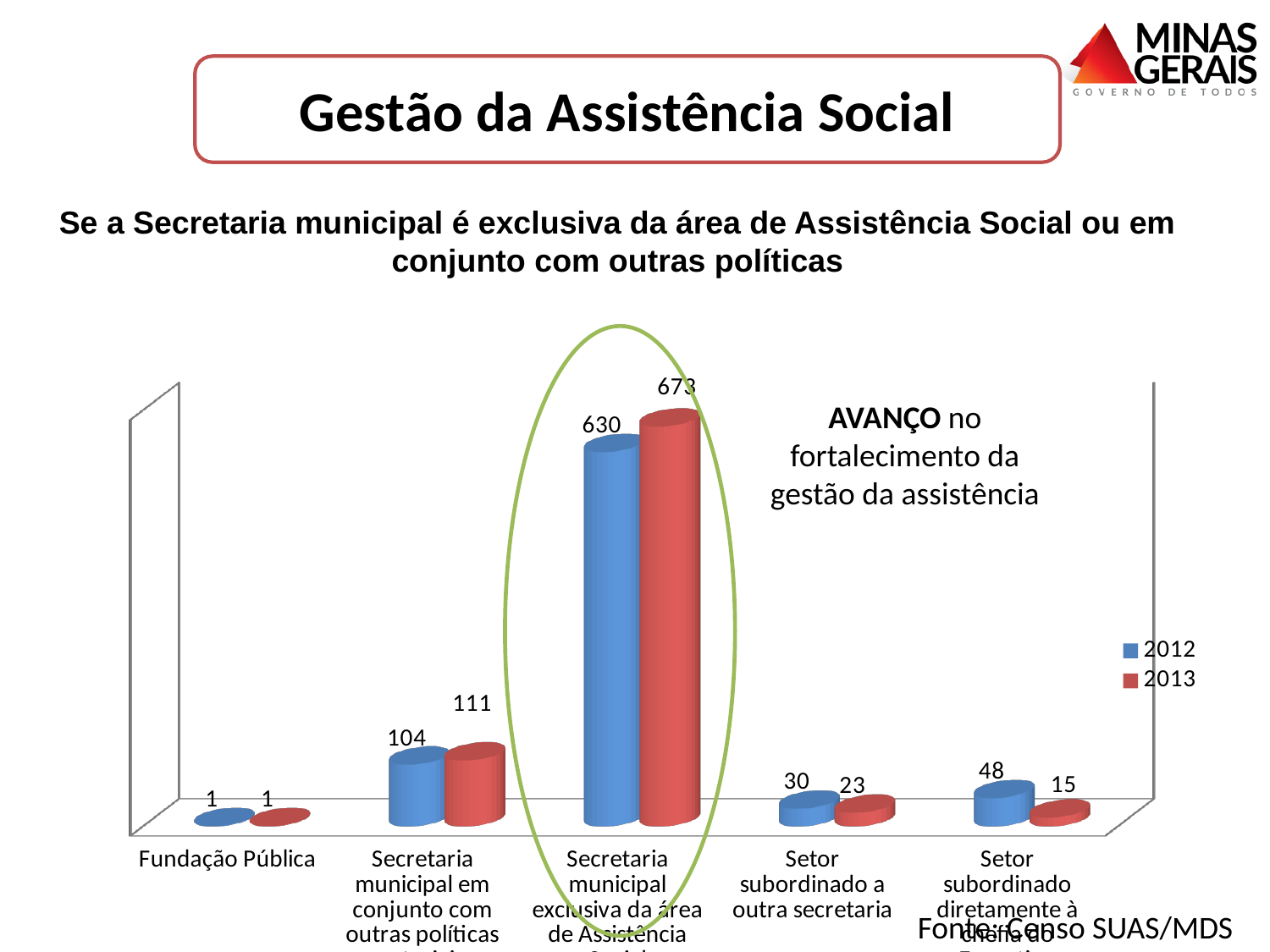
Which category has the lowest 2013 value? Fundação Pública What kind of chart is shown on the slide? Bar chart What is the difference between the 2013 and 2012 values for 'Secretaria municipal exclusiva da área de Assistência Social'? 43 What is the 2013 value for 'Secretaria municipal exclusiva da área de Assistência Social'? 673 How many categories are shown on the x axis of the chart? 5 Which colour represents the 2013 series in the chart? Red For 'Setor subordinado diretamente à chefia do Executivo', which year has the larger value, 2012 or 2013? 2012 Which category has the highest 2012 value? Secretaria municipal exclusiva da área de Assistência Social What is the 2012 value for 'Fundação Pública'? 1 How many series does the chart legend list? 2 What is the 2013 value for 'Setor subordinado a outra secretaria'? 23 What is the 2012 value for 'Secretaria municipal em conjunto com outras políticas'? 104